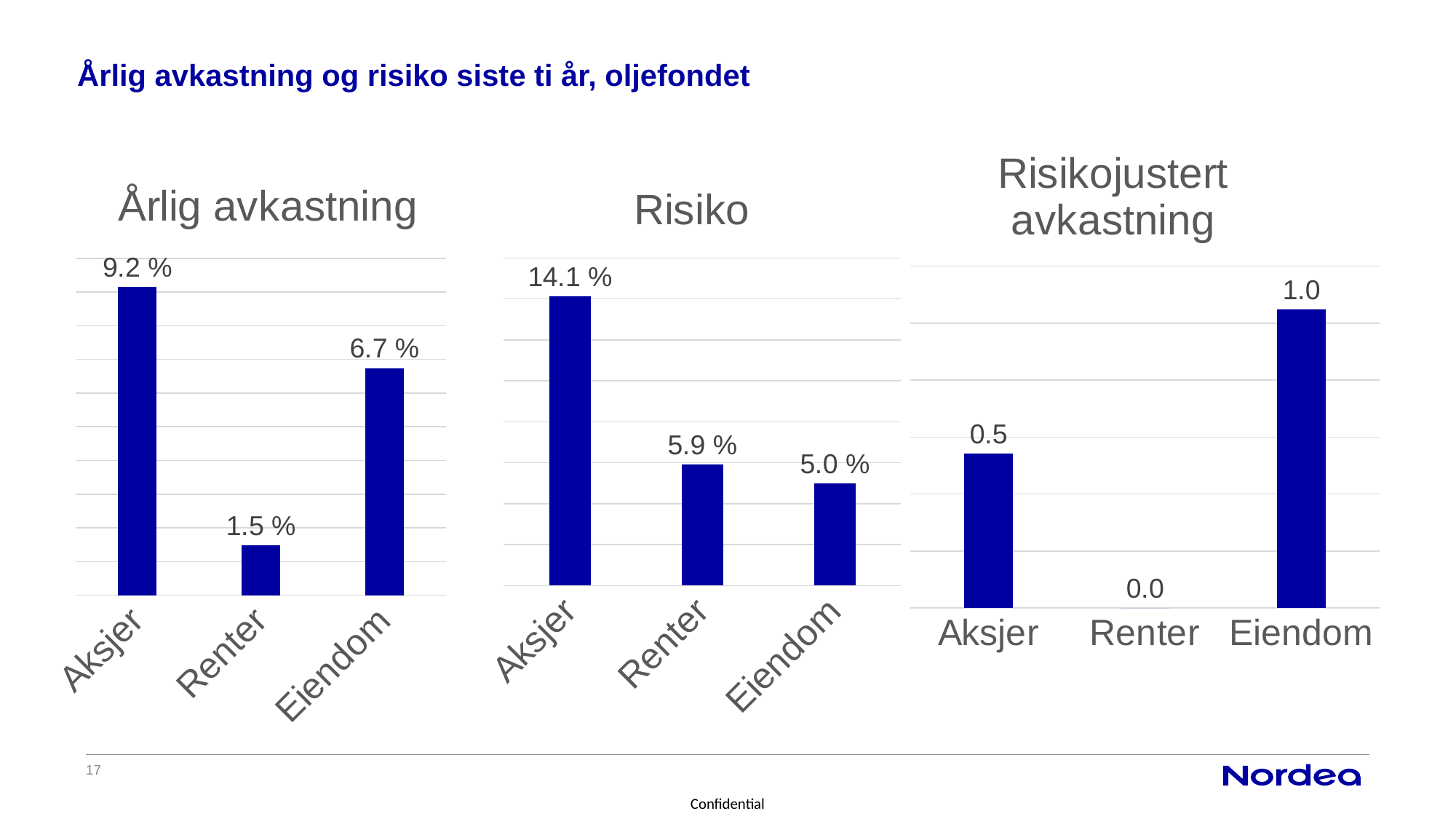
In the 'Årlig avkastning' chart, what is the difference between Aksjer and Eiendom? 2.5 % How many categories does the 'Årlig avkastning' chart show? 3 In the 'Risikojustert avkastning' chart, what is the value for Renter? 0.0 In the 'Risiko' chart, which is larger, Renter or Eiendom? Renter In the 'Risiko' chart, what is the difference between Aksjer and Eiendom? 9.1 % In the 'Risiko' chart, what is the value for Renter? 5.9 % What kind of chart is the 'Risiko' chart? Bar chart In the 'Risikojustert avkastning' chart, what is the value for Eiendom? 1.0 In the 'Årlig avkastning' chart, which category has the lowest value? Renter In the 'Årlig avkastning' chart, what is the value for Aksjer? 9.2 % In the 'Risiko' chart, which category has the highest value? Aksjer In the 'Risikojustert avkastning' chart, which category has the highest value? Eiendom